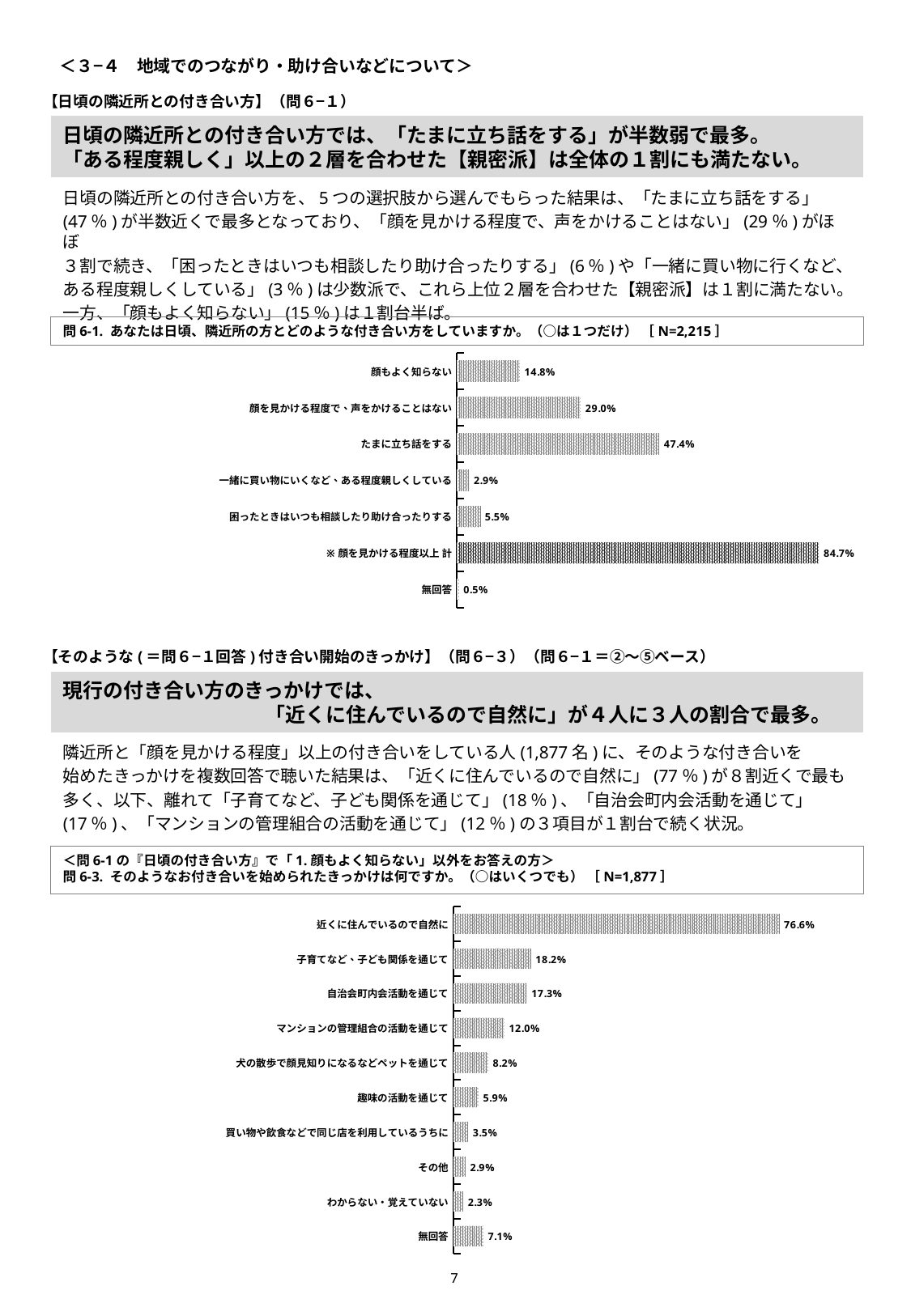
In the top chart (問6-1), how many bars are plotted? 7 In the top chart (問6-1), which of the five individual response options (excluding the 計 row and 無回答) has the lowest value? 一緒に買い物にいくなど、ある程度親しくしている In the top chart (問6-1), what is the value for 「顔もよく知らない」? 14.8% In the bottom chart (問6-3), what is the value for 「マンションの管理組合の活動を通じて」? 12.0% In the top chart (問6-1), what is the value for 「たまに立ち話をする」? 47.4% In the top chart (問6-1), which is larger: 「困ったときはいつも相談したり助け合ったりする」 or 「一緒に買い物にいくなど、ある程度親しくしている」? 困ったときはいつも相談したり助け合ったりする In the top chart (問6-1), what is the difference between 「顔を見かける程度で、声をかけることはない」 and 「顔もよく知らない」? 14.2% In the bottom chart (問6-3), which category has the lowest value? わからない・覚えていない In the bottom chart (問6-3), which category has the highest value? 近くに住んでいるので自然に In the bottom chart (問6-3), what is the value for 「近くに住んでいるので自然に」? 76.6% What type of chart is the bottom chart (問6-3)? Bar chart In the bottom chart (問6-3), what is the difference between 「子育てなど、子ども関係を通じて」 and 「自治会町内会活動を通じて」? 0.9%